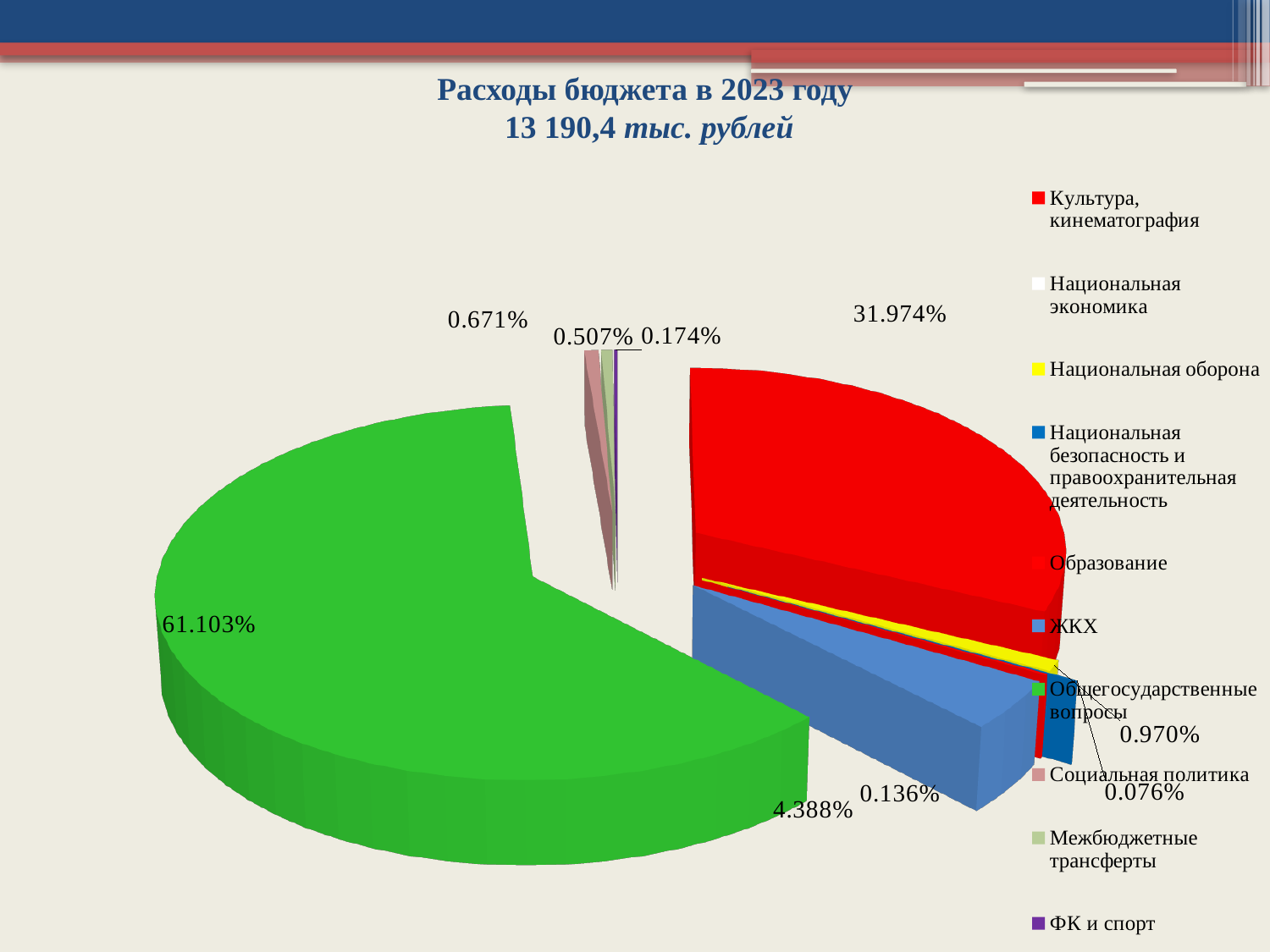
What is the difference between the shares of Культура, кинематография and ЖКХ? 27.586% What is the difference between the shares of Общегосударственные вопросы and Культура, кинематография? 29.129% Which is larger: the share of Культура, кинематография or the share of ЖКХ? Культура, кинематография What kind of chart is shown on the slide? Pie chart What share of the pie does Общегосударственные вопросы have? 61.103% What is the value shown for ЖКХ? 4.388% How many entries does the chart's legend list? 10 What is the title of the chart on the slide? Расходы бюджета в 2023 году 13 190,4 тыс. рублей What is the value shown for Социальная политика? 0.671% Which category has the largest share of the pie? Общегосударственные вопросы What colour is the slice for Общегосударственные вопросы? Green What is the value shown for Культура, кинематография? 31.974%